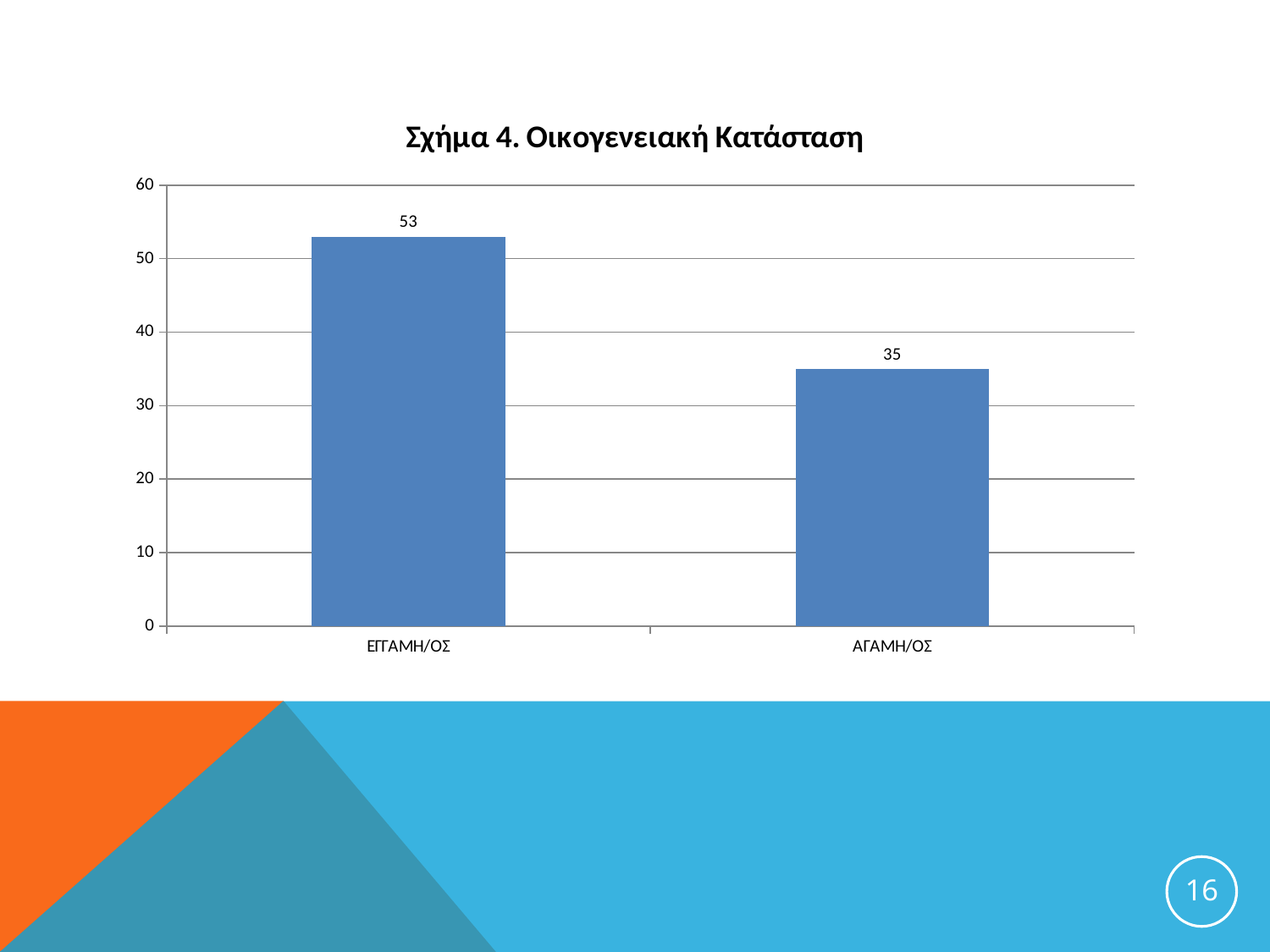
Which category has the lowest value? ΑΓΑΜΗ/ΟΣ What is the value for ΑΓΑΜΗ/ΟΣ? 35 What is the value for ΕΓΓΑΜΗ/ΟΣ? 53 What is the maximum value shown on the y axis? 60 What is the difference between the values for ΕΓΓΑΜΗ/ΟΣ and ΑΓΑΜΗ/ΟΣ? 18 What kind of chart is shown on the slide? bar chart Which category has the highest value? ΕΓΓΑΜΗ/ΟΣ Is the value for ΑΓΑΜΗ/ΟΣ greater or less than 40? less Which is larger, the value for ΕΓΓΑΜΗ/ΟΣ or the value for ΑΓΑΜΗ/ΟΣ? ΕΓΓΑΜΗ/ΟΣ How many categories are shown on the x axis? 2 What is the title of the chart? Σχήμα 4. Οικογενειακή Κατάσταση Is the value for ΕΓΓΑΜΗ/ΟΣ greater or less than 50? greater